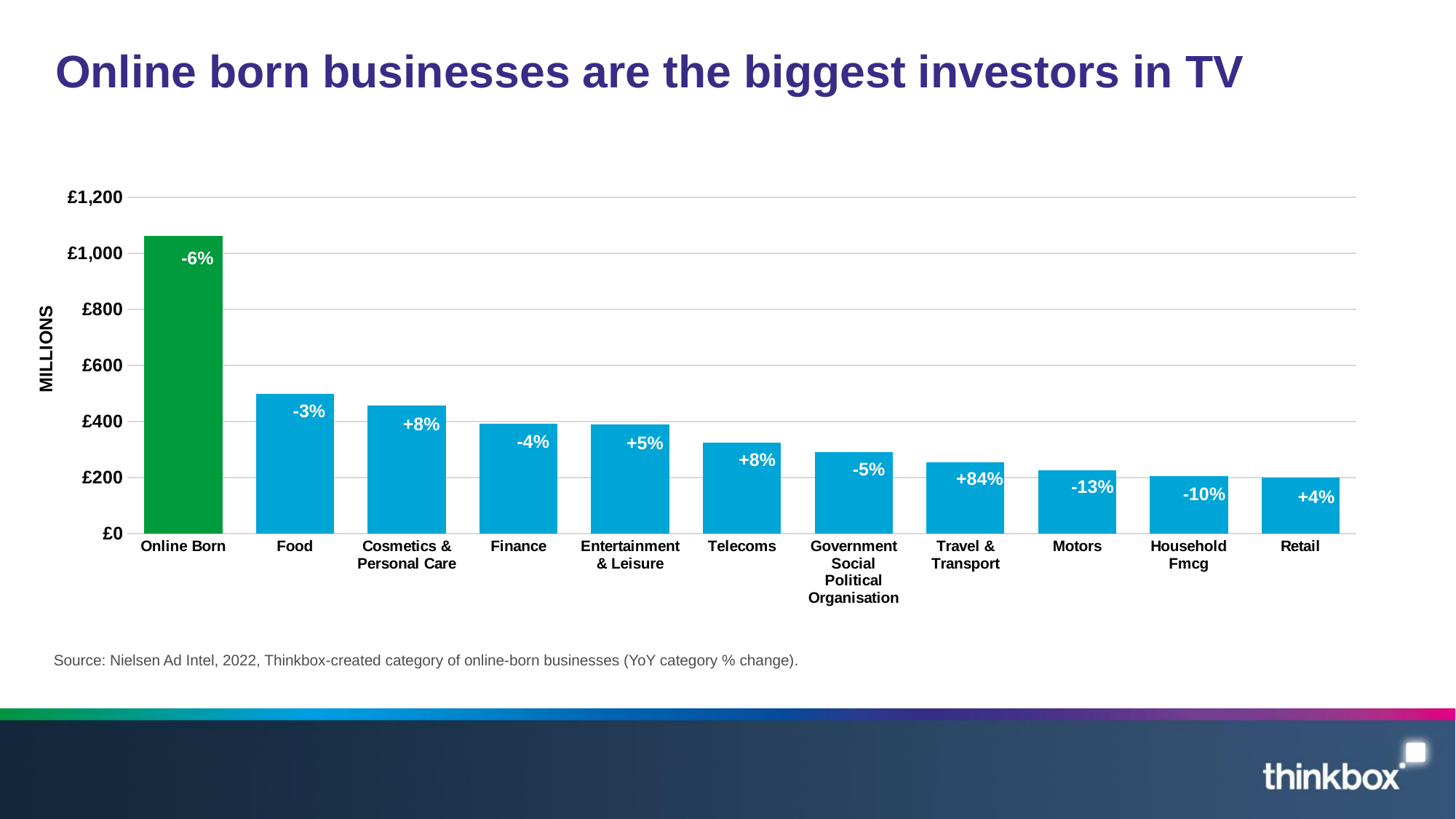
What YoY % change is labelled on the Cosmetics & Personal Care bar? +8% Is the value for Telecoms greater or less than £200? greater What YoY % change is labelled on the Online Born bar? -6% Do the bar values rise or fall moving from left to right along the x axis? fall Is the value for Online Born greater or less than £1,000? greater Which has a larger value, Food or Cosmetics & Personal Care? Food Is the value for Food greater or less than £600? less How many categories are shown on the x axis of the chart? 11 What YoY % change is labelled on the Travel & Transport bar? +84% What YoY % change is labelled on the Motors bar? -13% What kind of chart is shown on the slide? bar chart Which category has the highest TV investment in the chart? Online Born